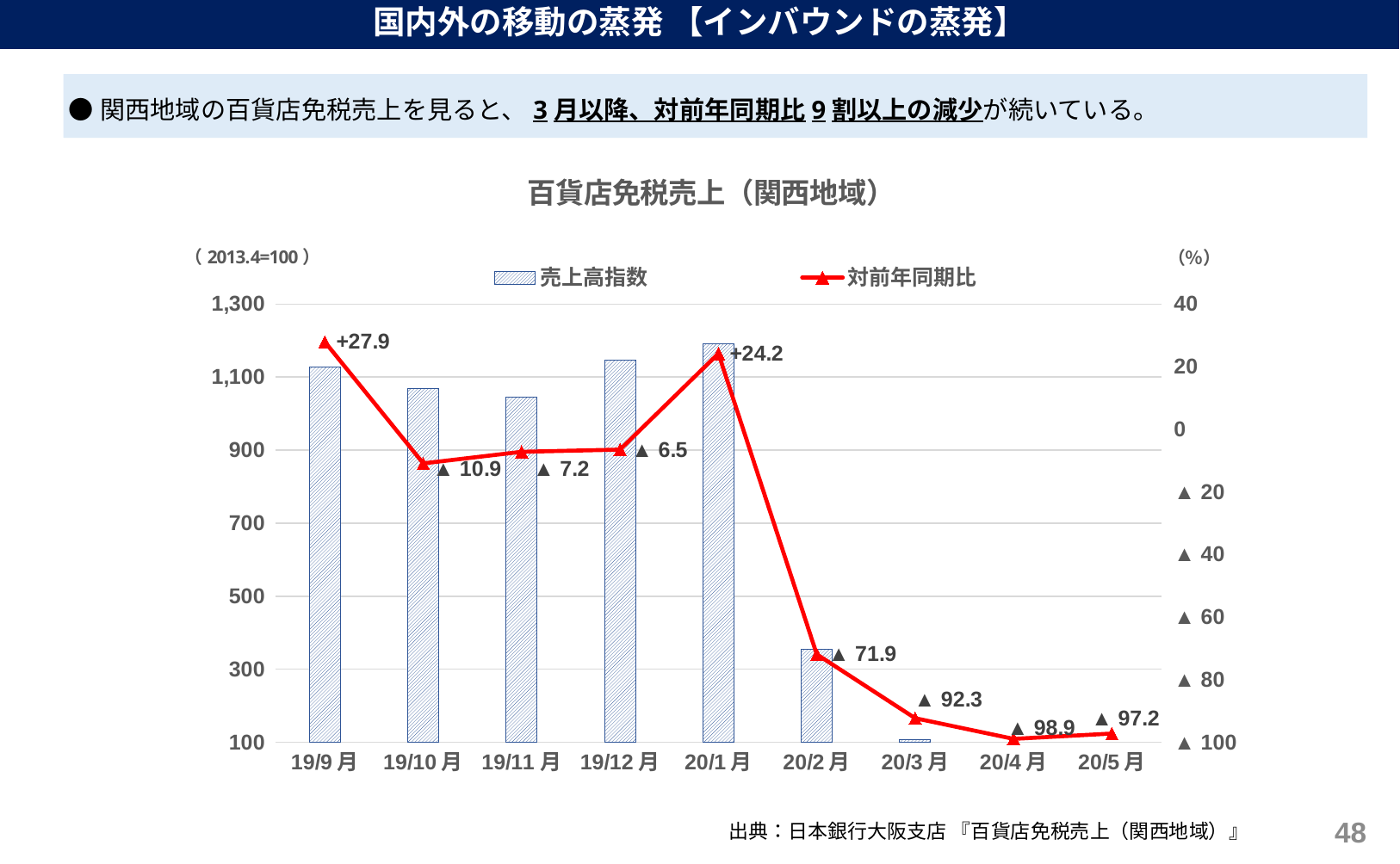
What is the 対前年同期比 value for 20/2月? ▲ 71.9 What is the 対前年同期比 value for 19/9月? +27.9 Which month shows the larger year-on-year decline in 対前年同期比, 19/10月 or 19/11月? 19/10月 Which month has the highest 対前年同期比 value? 19/9月 What is the difference between the 対前年同期比 values for 19/9月 (+27.9) and 20/1月 (+24.2)? 3.7 Is the 売上高指数 bar for 20/2月 greater or less than 500? less What is the 対前年同期比 value for 20/3月? ▲ 92.3 What kind of chart is shown? Combination bar and line chart How many series does the legend list? 2 How many months are shown on the x axis? 9 Is the 売上高指数 bar for 19/9月 greater or less than 1,100? greater Which month has the lowest 対前年同期比 value? 20/4月